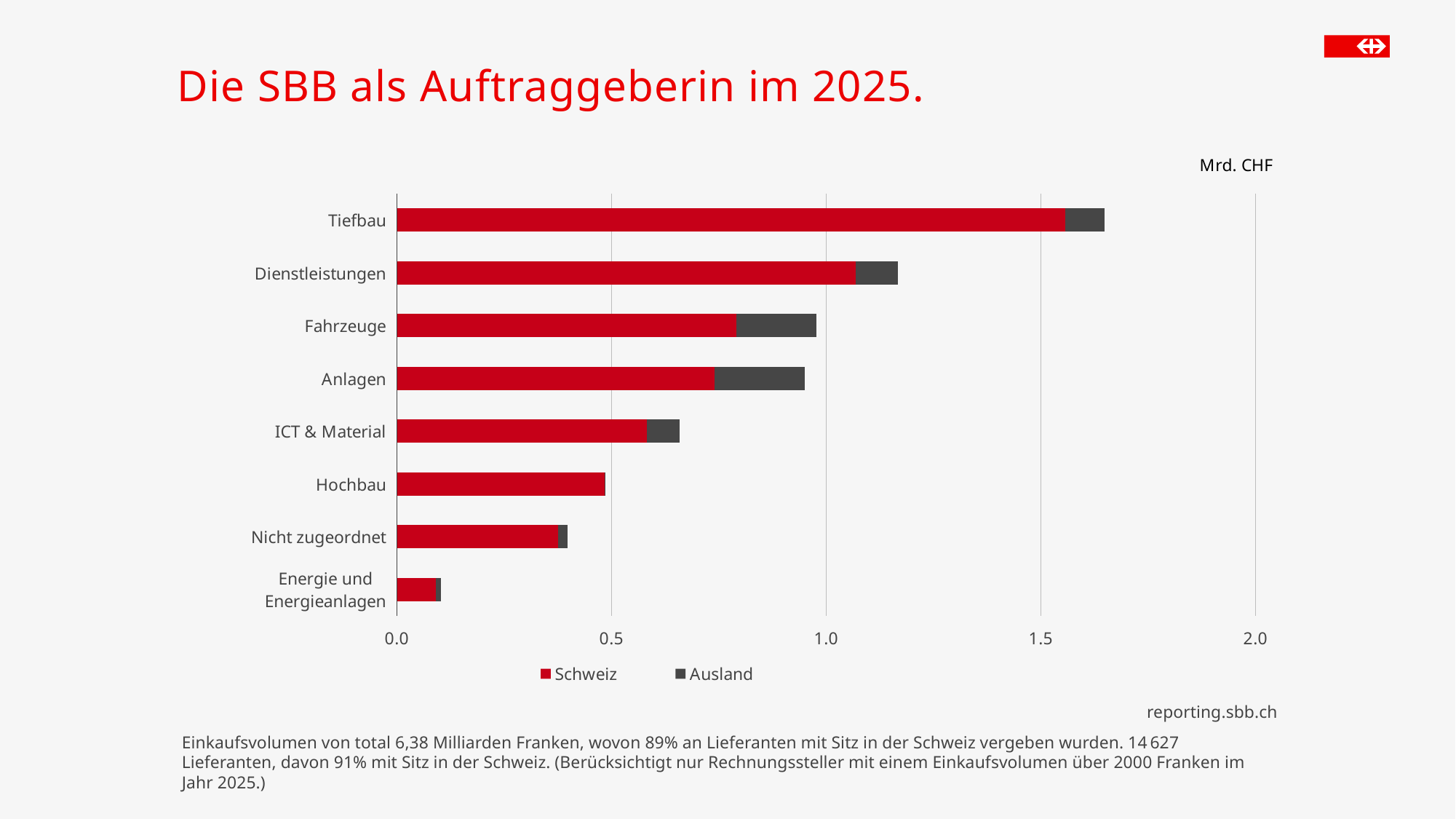
What kind of chart is shown on the slide? bar chart Is the total value for Dienstleistungen greater or less than 1.0? greater How many categories are shown on the chart? 8 What unit is shown above the chart? Mrd. CHF Which category has the shortest bar overall? Energie und Energieanlagen How many series does the legend list? 2 Which has a larger total value, Dienstleistungen or Fahrzeuge? Dienstleistungen Is the total value for ICT & Material greater or less than 0.5? greater Is the Schweiz value for Fahrzeuge greater or less than 0.5? greater Which category has the longest bar overall? Tiefbau